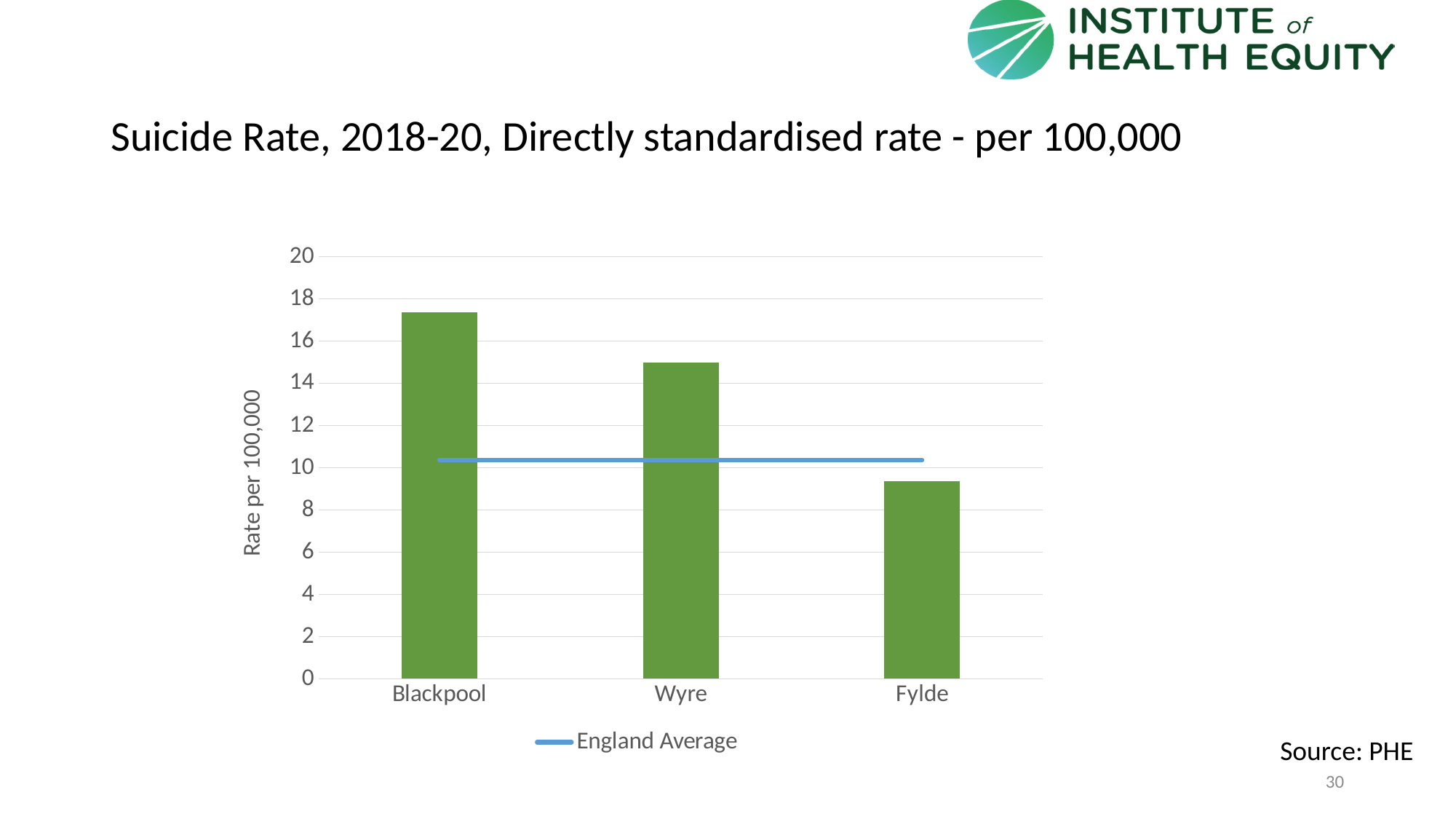
What type of chart is shown on the slide? bar chart Which area has the highest suicide rate? Blackpool Is the suicide rate for Wyre greater or less than 14? greater How many areas (bars) are plotted on the chart? 3 Is the suicide rate for Blackpool greater or less than 16? greater What is the label on the vertical axis of the chart? Rate per 100,000 Do the bar values rise or fall from left to right across the x axis? fall Which has a higher suicide rate, Wyre or Fylde? Wyre Which area has the lowest suicide rate? Fylde What does the blue horizontal line on the chart represent, according to the legend? England Average Is the suicide rate for Fylde greater or less than 10? less Which has a higher suicide rate, Blackpool or Wyre? Blackpool